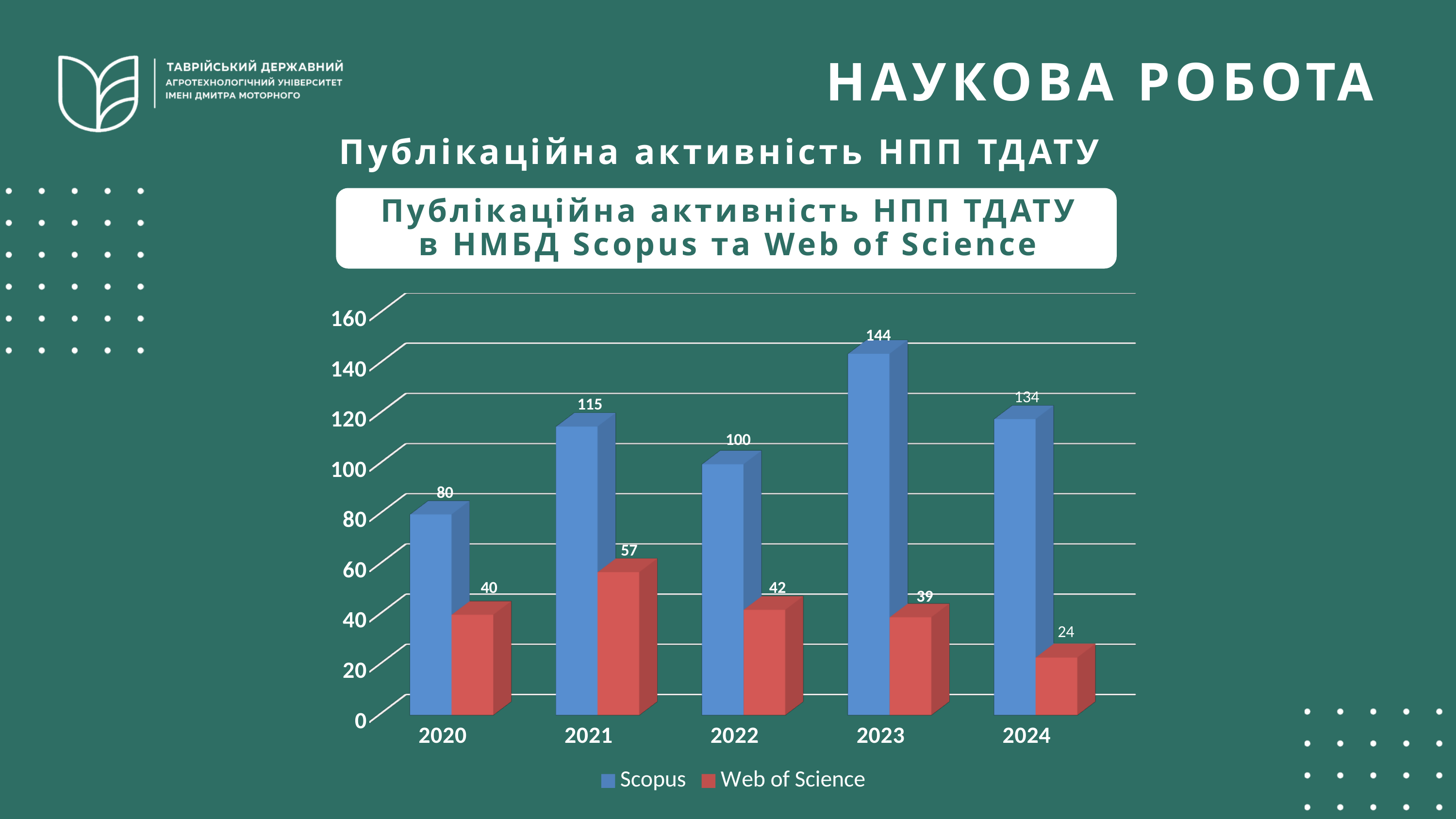
Which series is shown in red in the legend? Web of Science Which year has the lowest Web of Science value? 2024 What is the Scopus value for 2020? 80 What is the Scopus value for 2023? 144 Which year has the highest Scopus value? 2023 What is the difference between the Scopus and Web of Science values in 2024? 110 How many years are shown on the x axis? 5 How many series does the legend list? 2 What is the Web of Science value for 2021? 57 What kind of chart is shown on the slide? bar chart Which is larger: the Web of Science value for 2022 or for 2023? 2022 Do the Scopus values rise or fall from 2020 to 2021? rise